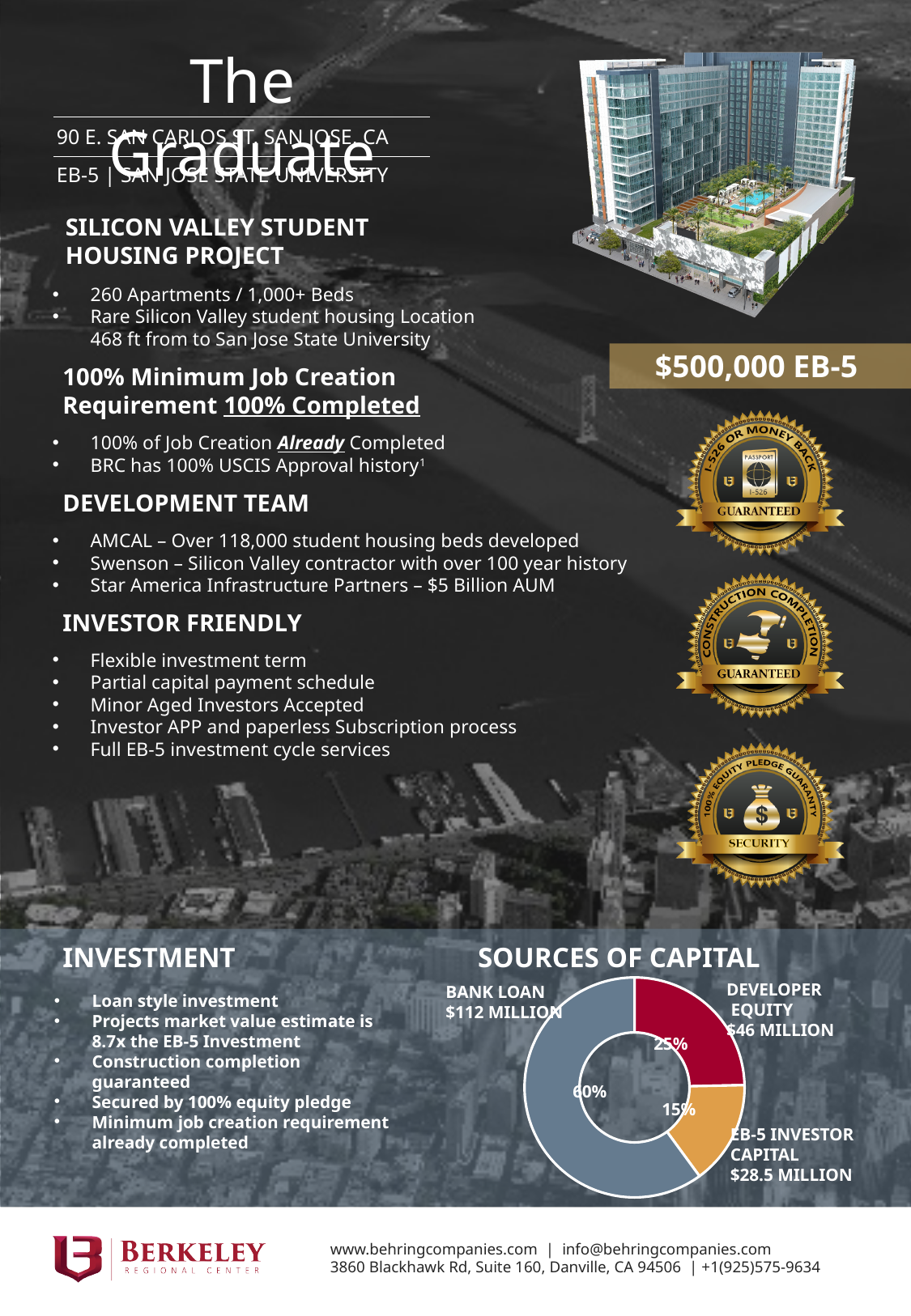
What is the value of the Bank Loan slice in the Sources of Capital chart? $112 million Which source of capital is the smallest in the Sources of Capital chart? EB-5 Investor Capital What percentage share of the Sources of Capital chart is Developer Equity? 25% In the Sources of Capital chart, what is the difference in percentage share between the Bank Loan and Developer Equity? 35% In the Sources of Capital chart, which is larger: Developer Equity or EB-5 Investor Capital? Developer Equity Which source of capital is the largest in the Sources of Capital chart? Bank Loan What percentage share of the Sources of Capital chart is EB-5 Investor Capital? 15% How many slices does the Sources of Capital chart have? 3 What is the value of the EB-5 Investor Capital slice in the Sources of Capital chart? $28.5 million What percentage share of the Sources of Capital chart is the Bank Loan? 60% What is the value of the Developer Equity slice in the Sources of Capital chart? $46 million What kind of chart is shown under "Sources of Capital"? Donut (pie) chart